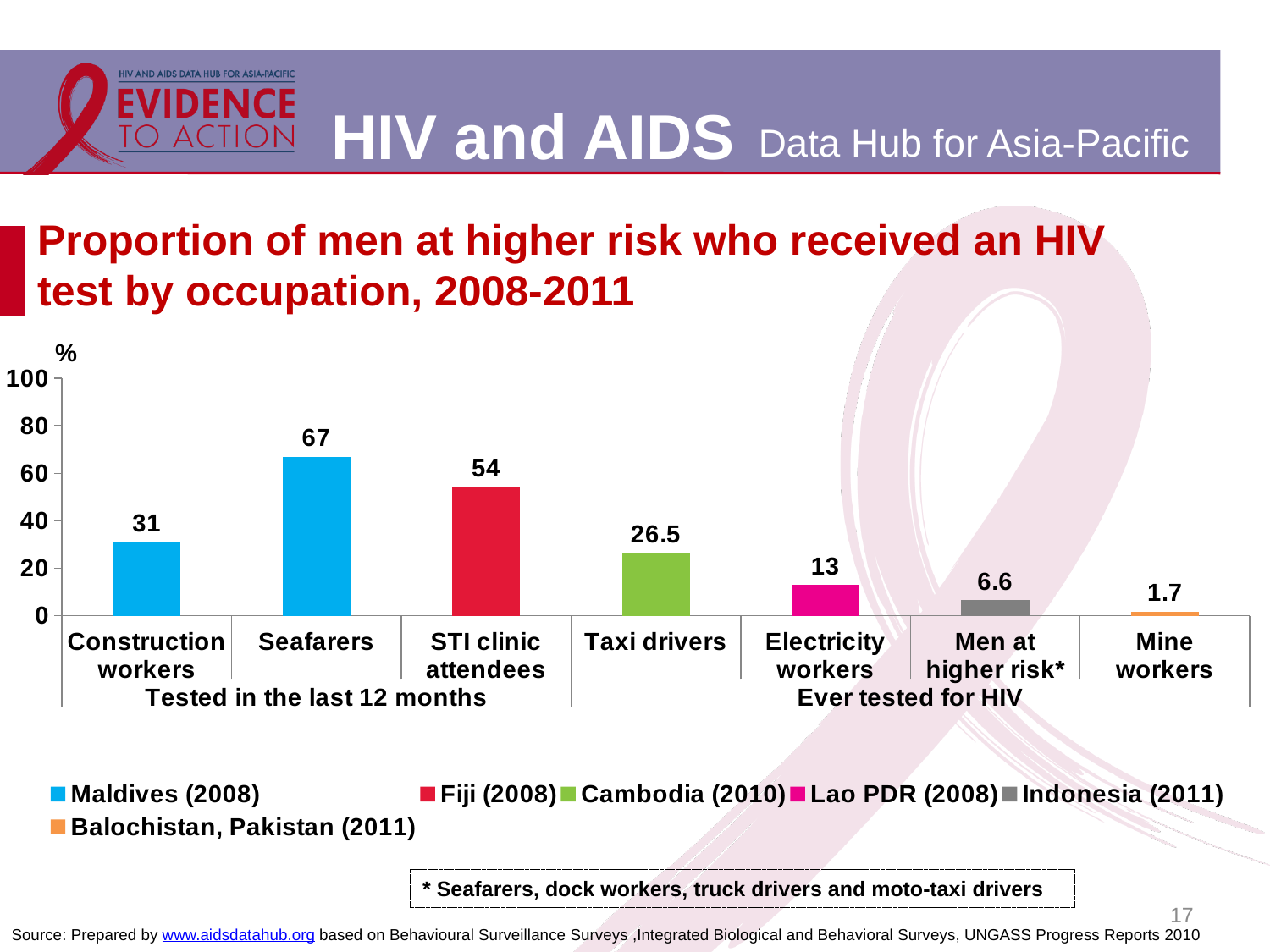
What is the difference between the values for Seafarers and STI clinic attendees? 13 What kind of chart is shown? bar chart Which legend entry corresponds to the Men at higher risk bar? Indonesia (2011) How many series does the legend list? 6 Which occupation has the lowest value? Mine workers Which occupation has the highest value? Seafarers What is the value for Seafarers? 67 Is the value for Electricity workers greater or less than 20? less What is the value for Taxi drivers? 26.5 How many occupation categories are shown on the chart? 7 Which is larger, the value for Construction workers or the value for Taxi drivers? Construction workers What is the value for Mine workers? 1.7